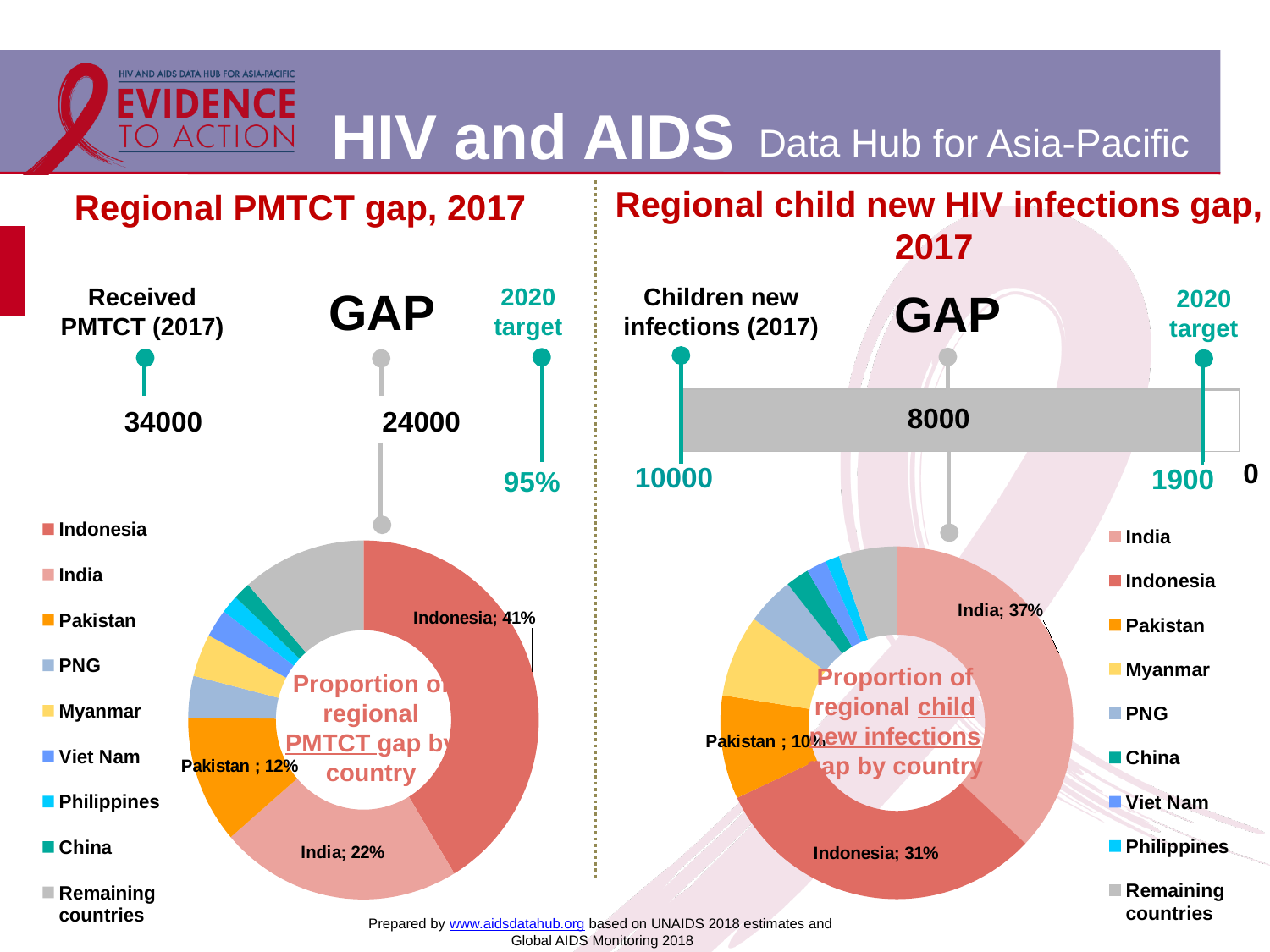
In the 'Proportion of regional PMTCT gap by country' chart, what share of the gap is Pakistan? 12% In the 'Proportion of regional PMTCT gap by country' chart, what share of the gap is Indonesia? 41% In the 'Proportion of regional PMTCT gap by country' chart, which country has the largest slice? Indonesia In the 'Proportion of regional PMTCT gap by country' chart, how many percentage points larger is Indonesia's share than India's? 19 percentage points In the 'Proportion of regional PMTCT gap by country' chart, what share of the gap is India? 22% In the 'Proportion of regional child new infections gap by country' chart, how many percentage points larger is India's share than Indonesia's? 6 percentage points How many entries does the legend of the 'Proportion of regional PMTCT gap by country' chart list? 9 In the 'Proportion of regional child new infections gap by country' chart, which country has the largest slice? India What kind of chart is the 'Proportion of regional PMTCT gap by country' chart on the left? doughnut chart